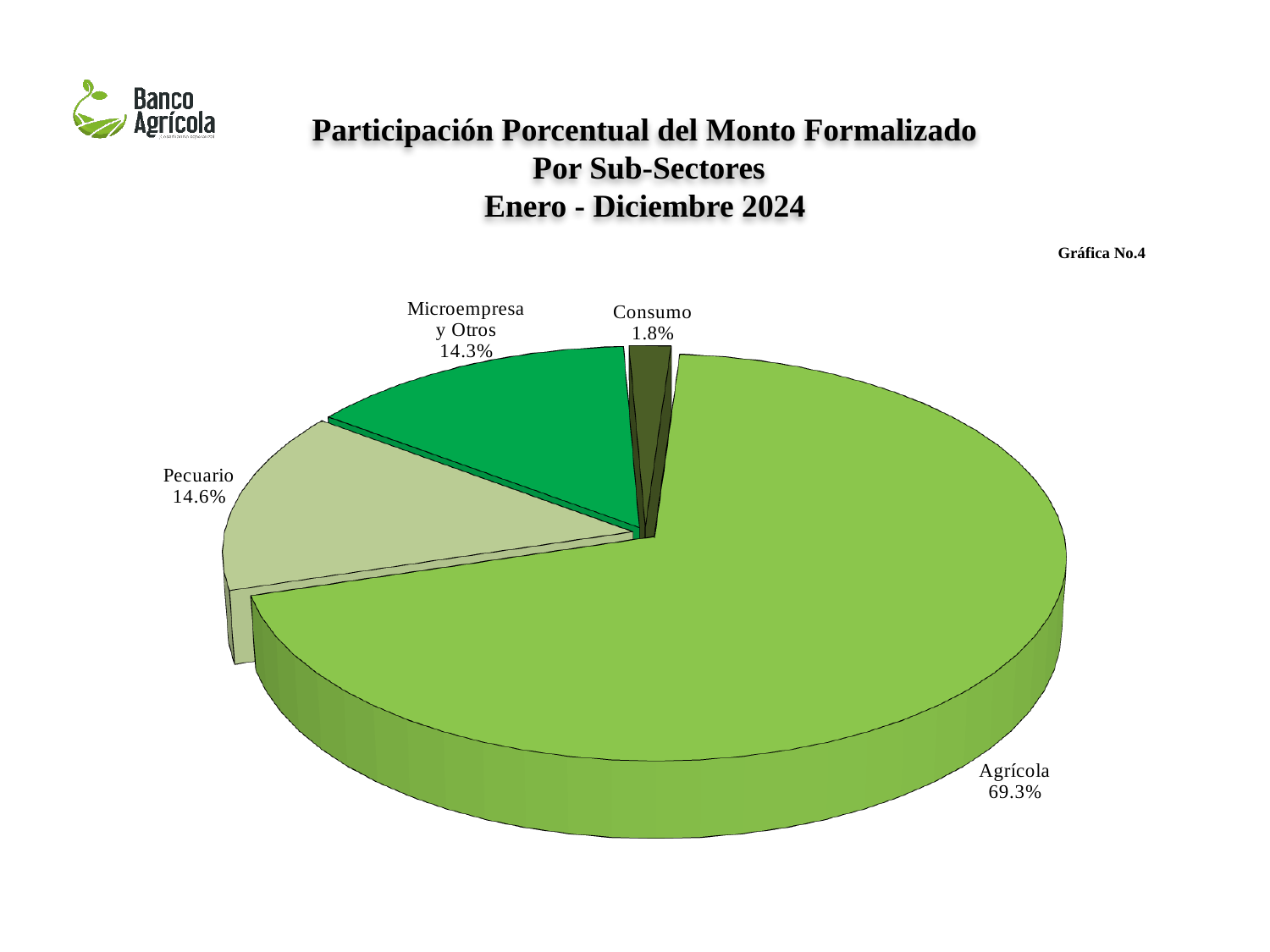
Which sub-sector has the largest share of the pie? Agrícola What share of the pie does Pecuario hold? 14.6% Which has a larger share, Agrícola or Consumo? Agrícola What share of the pie does Consumo hold? 1.8% What share of the pie does Microempresa y Otros hold? 14.3% What is the difference in percentage points between Agrícola and Pecuario? 54.7 What is the title of the chart? Participación Porcentual del Monto Formalizado Por Sub-Sectores Enero - Diciembre 2024 How many sub-sectors (slices) are shown in the pie chart? 4 What kind of chart is shown on the slide? Pie chart What share of the pie does Agrícola hold? 69.3% What is the difference in percentage points between Pecuario and Microempresa y Otros? 0.3 Which sub-sector has the smallest share of the pie? Consumo